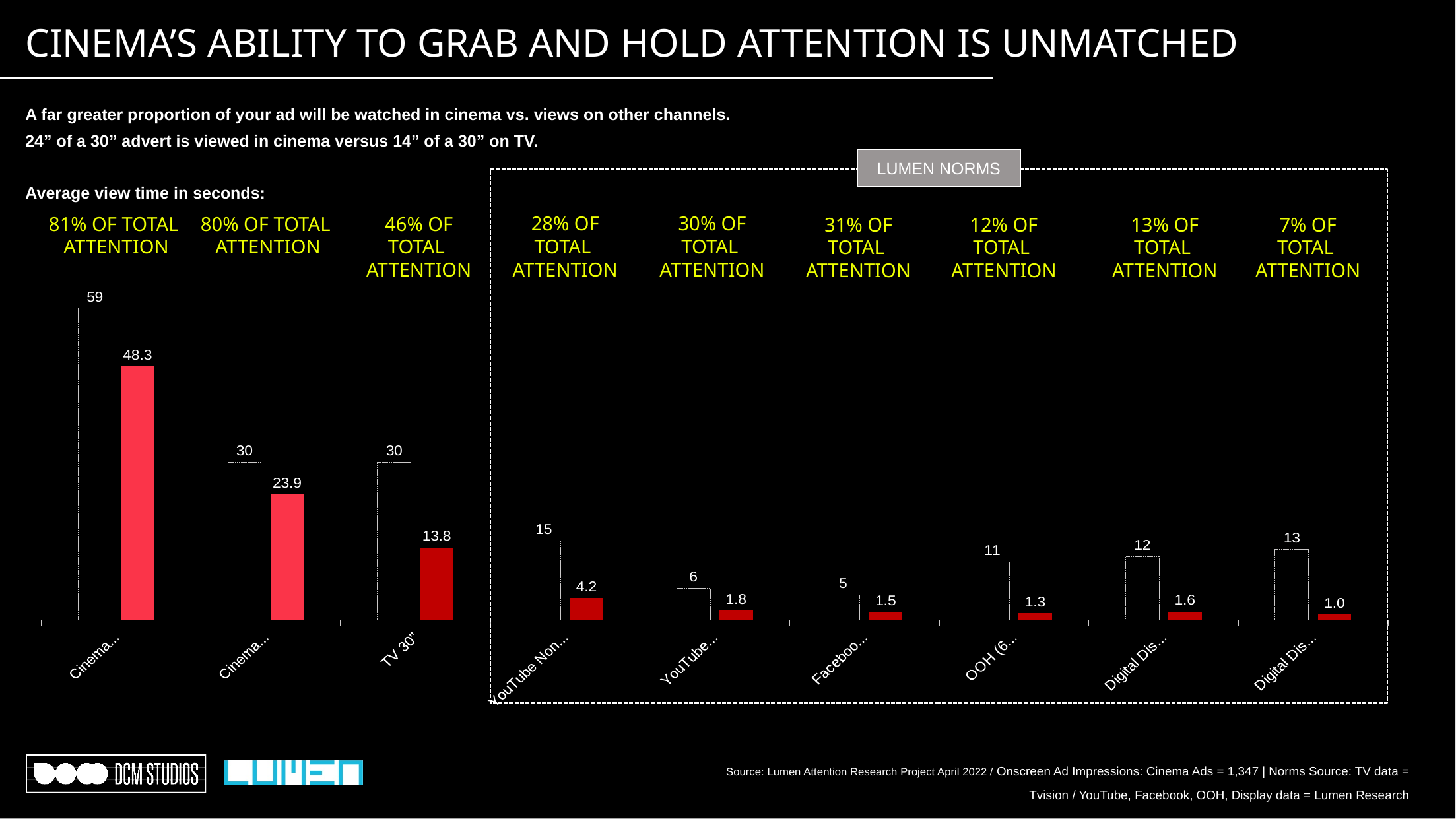
What is the value of the dashed outline bar for the TV 30" category? 30 For the first Cinema category, what is the difference between the dashed outline bar (59) and the filled red bar (48.3)? 10.7 What kind of chart is shown on the slide? bar chart What is the value of the filled red bar for the TV 30" category? 13.8 Which has the larger filled red bar: the YouTube Non... category or the Faceboo... category? YouTube Non... How many categories are shown along the x axis of the chart? 9 For the TV 30" category, what is the difference between the dashed outline bar and the filled red bar? 16.2 What label appears in the grey box at the top of the dashed outlined area of the chart? LUMEN NORMS What percentage of total attention is shown above the TV 30" category? 46% OF TOTAL ATTENTION What is the lowest value shown by any filled red bar on the chart? 1.0 What is the highest value shown by any filled red bar on the chart? 48.3 What is the value of the filled red bar for the OOH category? 1.3